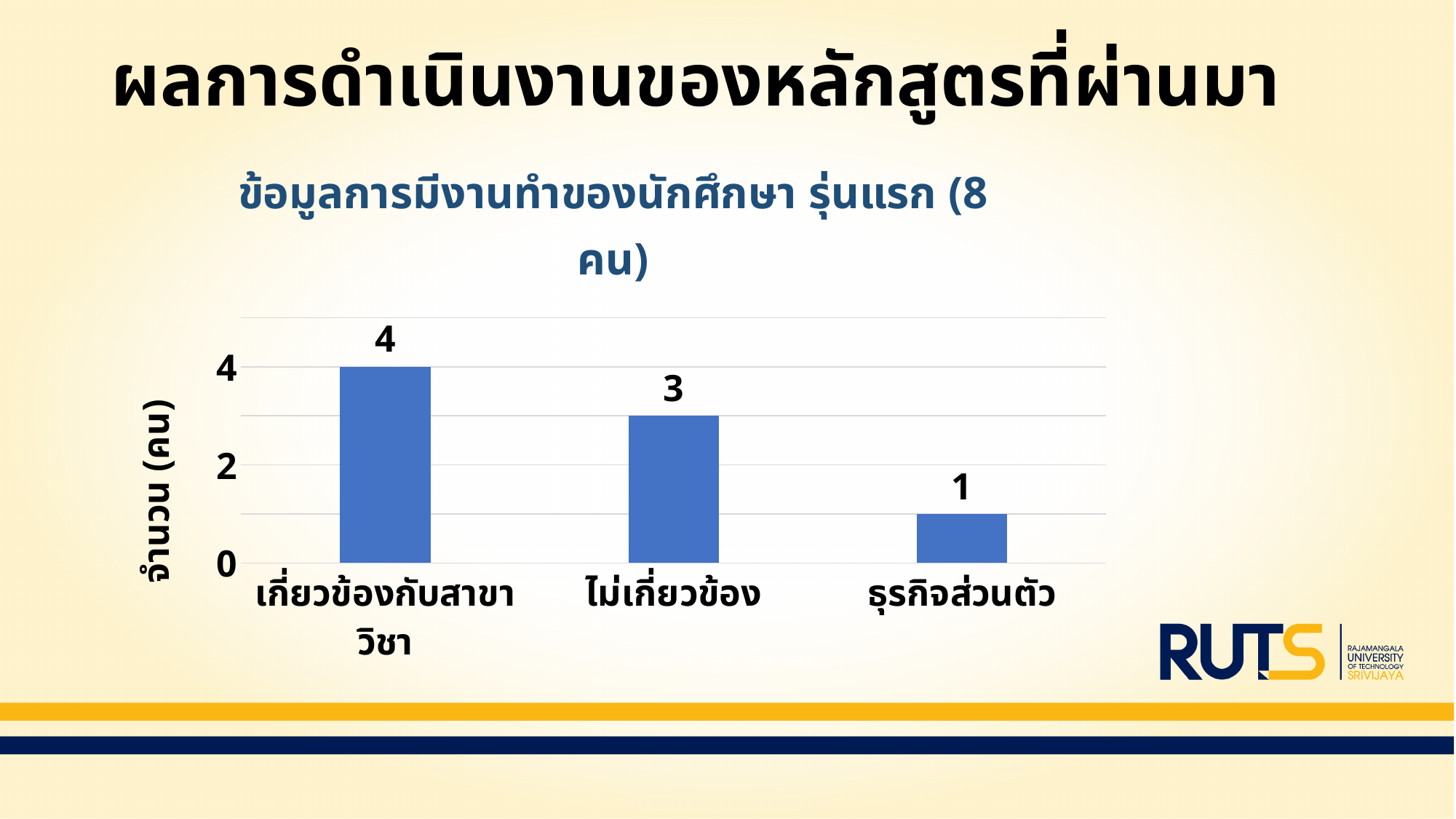
Which category has the lowest value? ธุรกิจส่วนตัว How many categories are shown in the chart? 3 Is the value for ไม่เกี่ยวข้อง greater or less than 2? greater What is the value for เกี่ยวข้องกับสาขาวิชา? 4 What is the label of the vertical axis? จำนวน (คน) Which is larger, the value for ไม่เกี่ยวข้อง or the value for ธุรกิจส่วนตัว? ไม่เกี่ยวข้อง What is the value for ธุรกิจส่วนตัว? 1 What is the difference between the values for เกี่ยวข้องกับสาขาวิชา and ไม่เกี่ยวข้อง? 1 What is the value for ไม่เกี่ยวข้อง? 3 Which category has the highest value? เกี่ยวข้องกับสาขาวิชา What kind of chart is shown on the slide? bar chart What is the difference between the values for เกี่ยวข้องกับสาขาวิชา and ธุรกิจส่วนตัว? 3